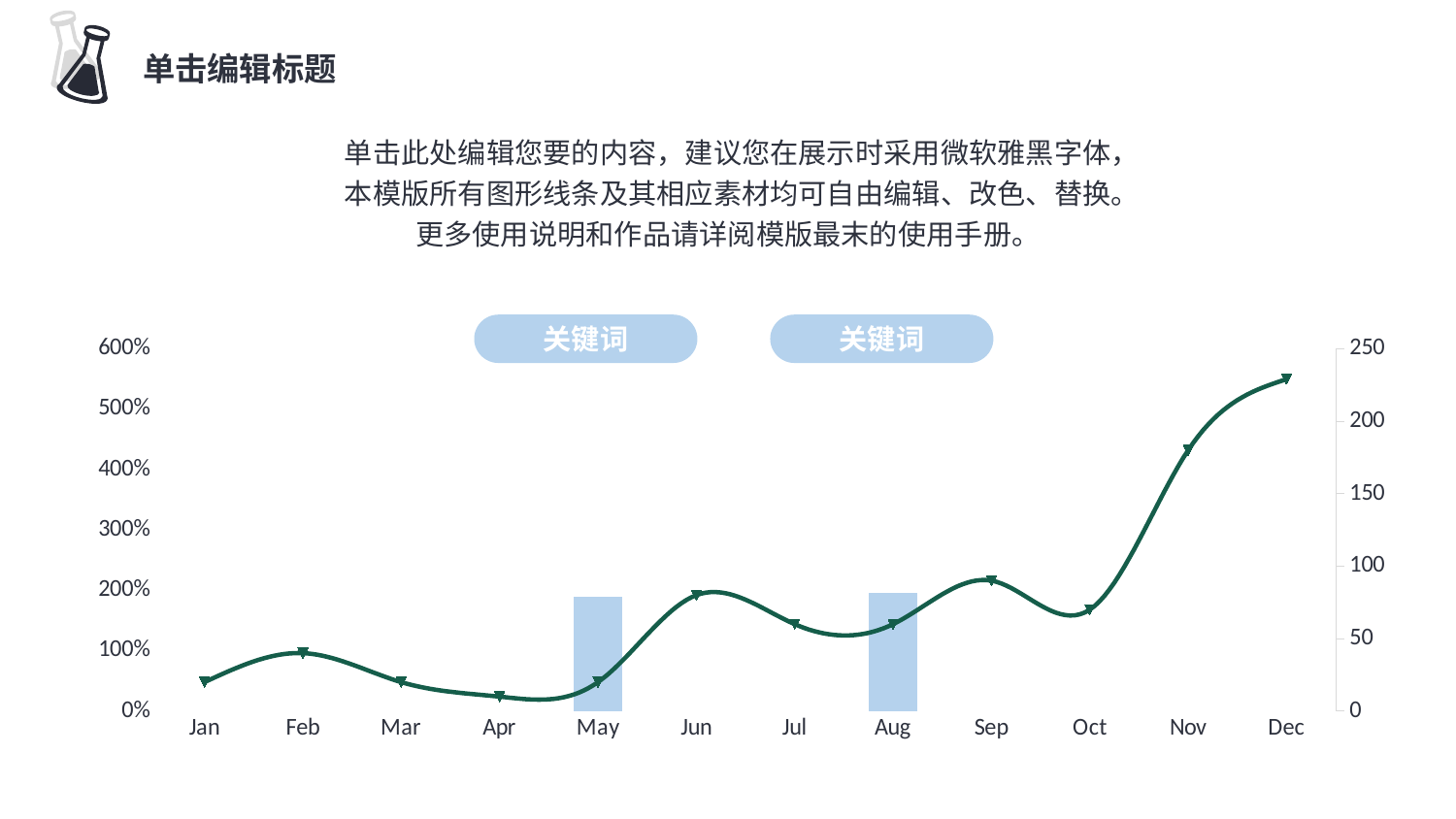
Does the line rise or fall from Jun to Jul? fall How many bars are drawn in the chart? 2 Which month has the higher line value, Feb or Mar? Feb How many months are shown on the x axis of the chart? 12 Which month has the higher line value, Jun or Jul? Jun Which month has the higher line value, Dec or Jan? Dec Which months have a bar drawn in the chart? May and Aug Does the line rise or fall from Oct to Dec? rise Which month has the lowest point on the line? Apr Which month has the highest point on the line? Dec What kind of chart is shown on the slide? a line chart combined with a bar chart